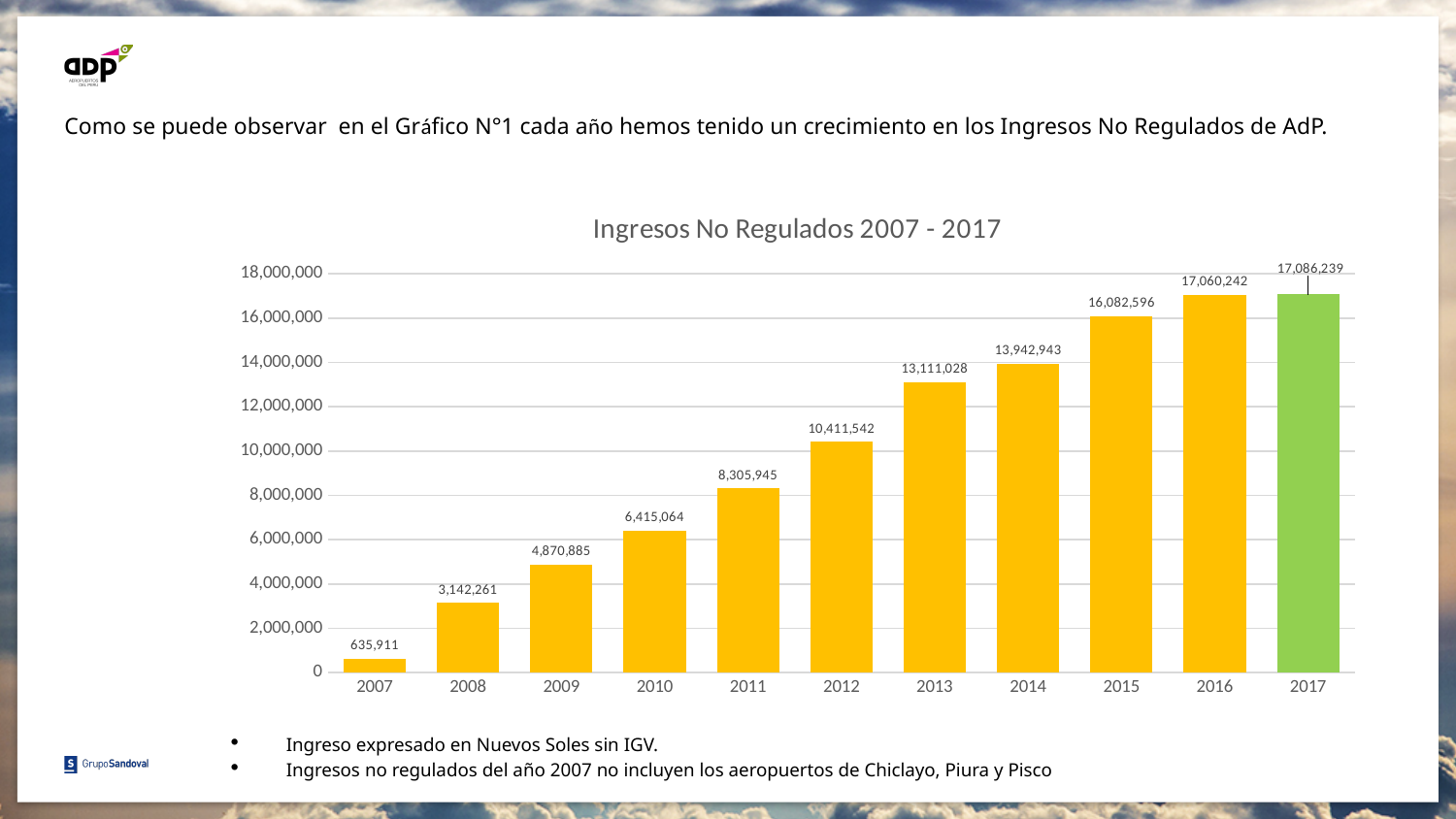
Which year has the highest value? 2017 What is the value for 2012? 10,411,542 What is the value for 2007? 635,911 What is the value for 2015? 16,082,596 What is the difference between the values for 2014 and 2013? 831,915 Which year has the lowest value? 2007 How many years are plotted in the chart? 11 What type of chart is shown on the slide? bar chart What is the difference between the values for 2017 and 2016? 25,997 Which is larger, the value for 2010 or the value for 2011? 2011 What is the title of the chart? Ingresos No Regulados 2007 - 2017 Do the values rise or fall from 2007 to 2017? rise